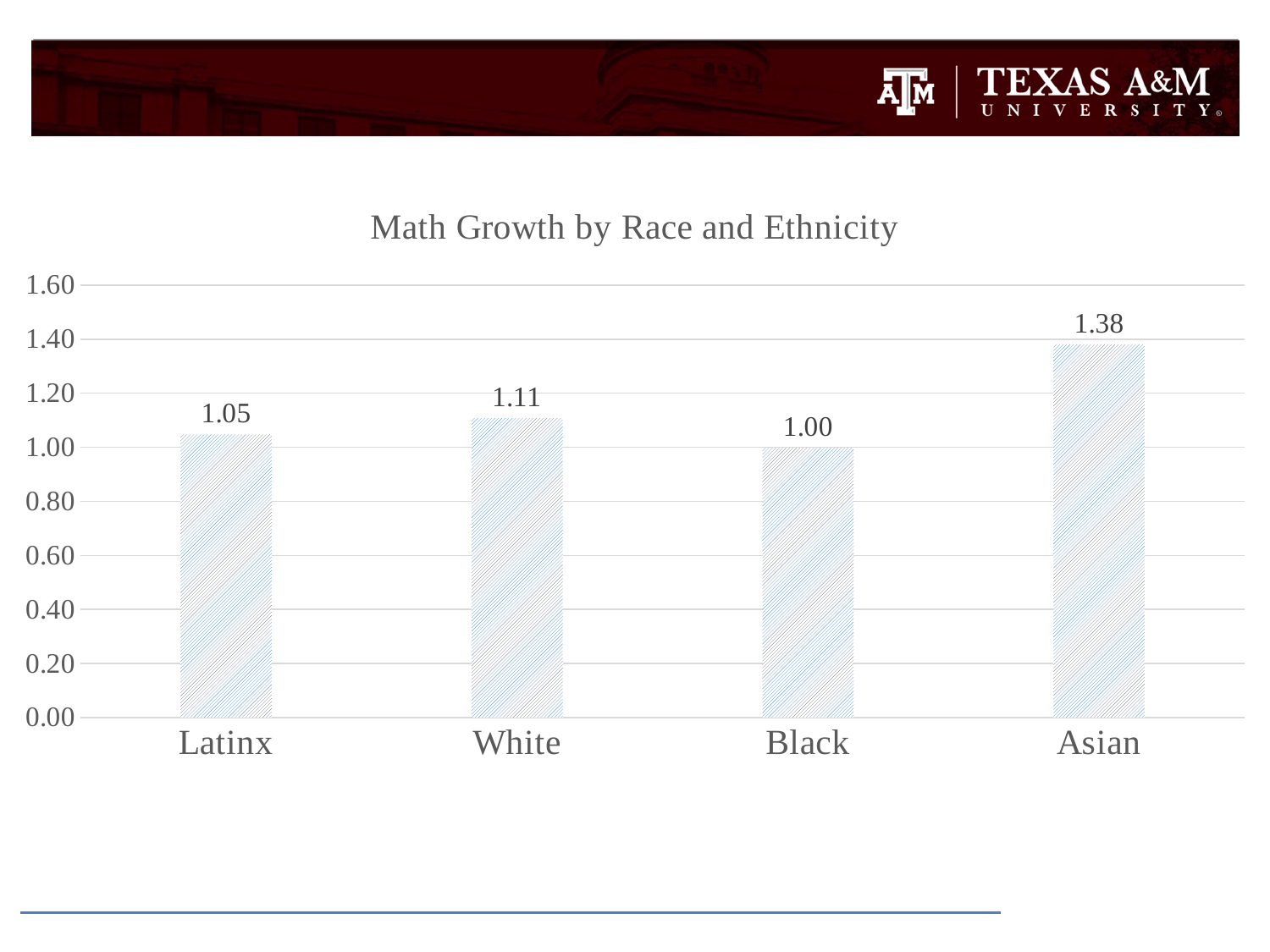
What is the math growth value for Black students? 1.00 What is the math growth value for White students? 1.11 What is the math growth value for Asian students? 1.38 Which group has the lowest math growth? Black Is the value for Asian greater or less than 1.20? greater What is the math growth value for Latinx students? 1.05 What is the difference between the math growth values for Asian and Black students? 0.38 Which group has a larger math growth value, White or Latinx? White What type of chart is shown on the slide? Bar chart How many race and ethnicity groups are shown in the chart? 4 What is the difference between the math growth values for White and Latinx students? 0.06 Which group has the highest math growth? Asian